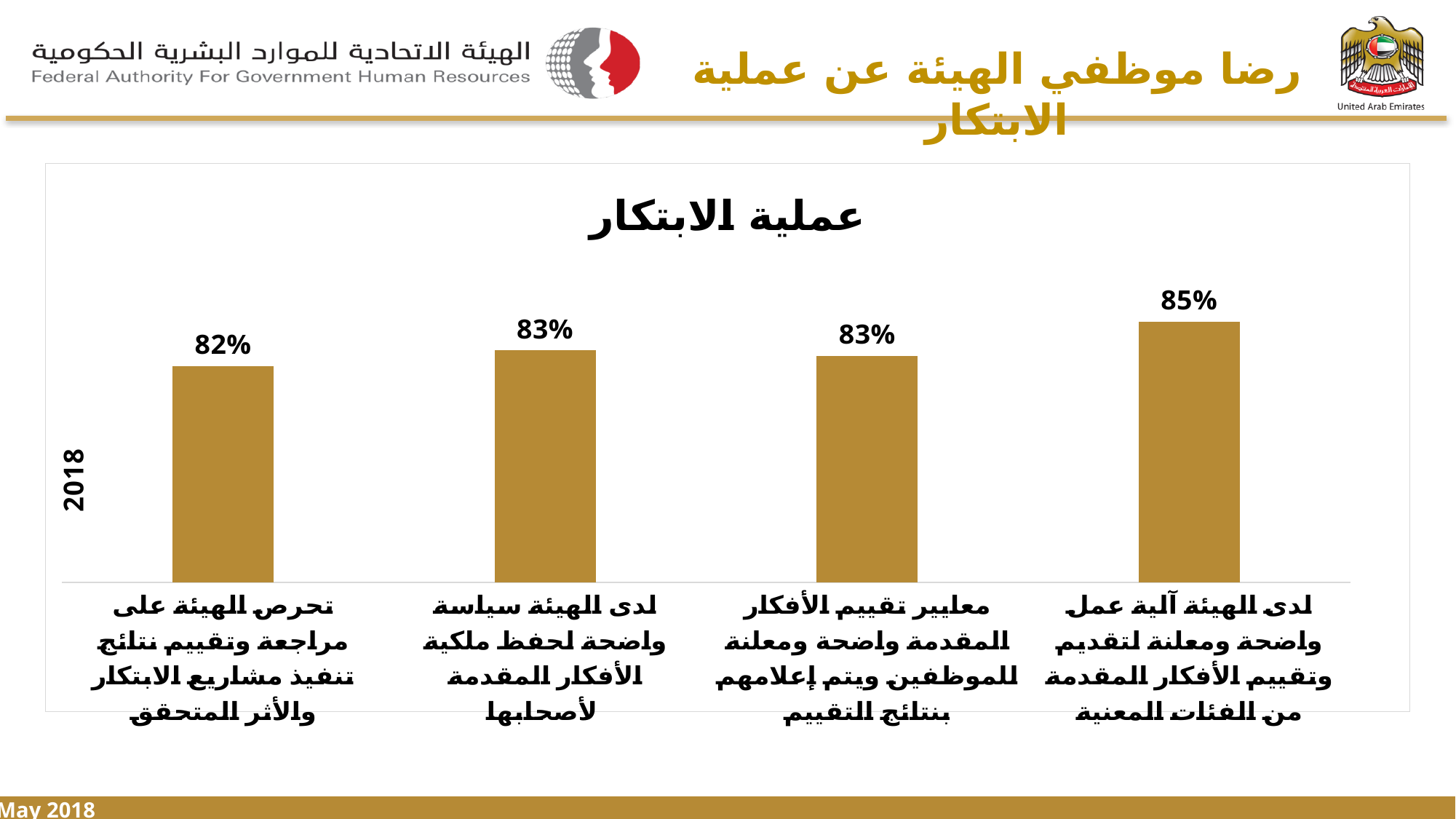
Which is larger: the value for "لدى الهيئة آلية عمل واضحة ومعلنة لتقديم وتقييم الأفكار المقدمة من الفئات المعنية" or the value for "تحرص الهيئة على مراجعة وتقييم نتائج تنفيذ مشاريع الابتكار والأثر المتحقق"? لدى الهيئة آلية عمل واضحة ومعلنة لتقديم وتقييم الأفكار المقدمة من الفئات المعنية Which category has the lowest value? تحرص الهيئة على مراجعة وتقييم نتائج تنفيذ مشاريع الابتكار والأثر المتحقق What is the value for "لدى الهيئة آلية عمل واضحة ومعلنة لتقديم وتقييم الأفكار المقدمة من الفئات المعنية"? 85% How many categories (bars) does the chart show? 4 What type of chart is shown on the slide? Bar chart What label is shown on the vertical axis of the chart? 2018 Which category has the highest value? لدى الهيئة آلية عمل واضحة ومعلنة لتقديم وتقييم الأفكار المقدمة من الفئات المعنية What is the difference between the highest value (85%) and the lowest value (82%)? 3 percentage points What is the value for "تحرص الهيئة على مراجعة وتقييم نتائج تنفيذ مشاريع الابتكار والأثر المتحقق"? 82% What is the title of the chart? عملية الابتكار What is the value for "لدى الهيئة سياسة واضحة لحفظ ملكية الأفكار المقدمة لأصحابها"? 83% What is the value for "معايير تقييم الأفكار المقدمة واضحة ومعلنة للموظفين ويتم إعلامهم بنتائج التقييم"? 83%